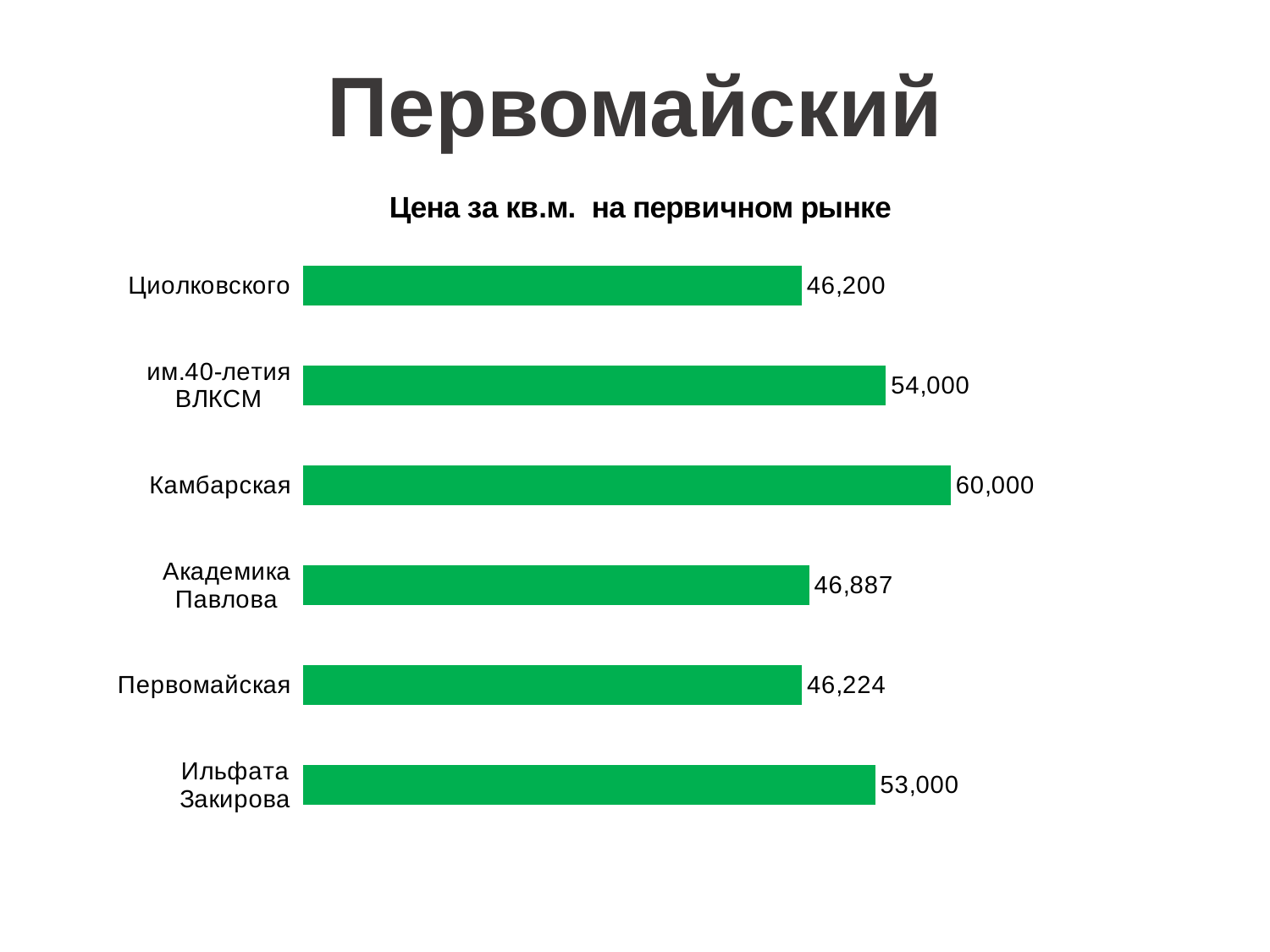
What is the title of the chart? Цена за кв.м. на первичном рынке What is the price per sq.m. for Академика Павлова? 46,887 What is the price per sq.m. for Камбарская? 60,000 What is the difference between the price for им.40-летия ВЛКСМ and the price for Ильфата Закирова? 1,000 What is the difference between the price for Камбарская and the price for им.40-летия ВЛКСМ? 6,000 Which street has the highest price per sq.m.? Камбарская What is the price per sq.m. for Циолковского? 46,200 How many streets are shown in the chart? 6 Which is larger: the price for Первомайская or the price for Ильфата Закирова? Ильфата Закирова Which street has the lowest price per sq.m.? Циолковского What is the price per sq.m. for Ильфата Закирова? 53,000 What kind of chart is shown on the slide? Bar chart